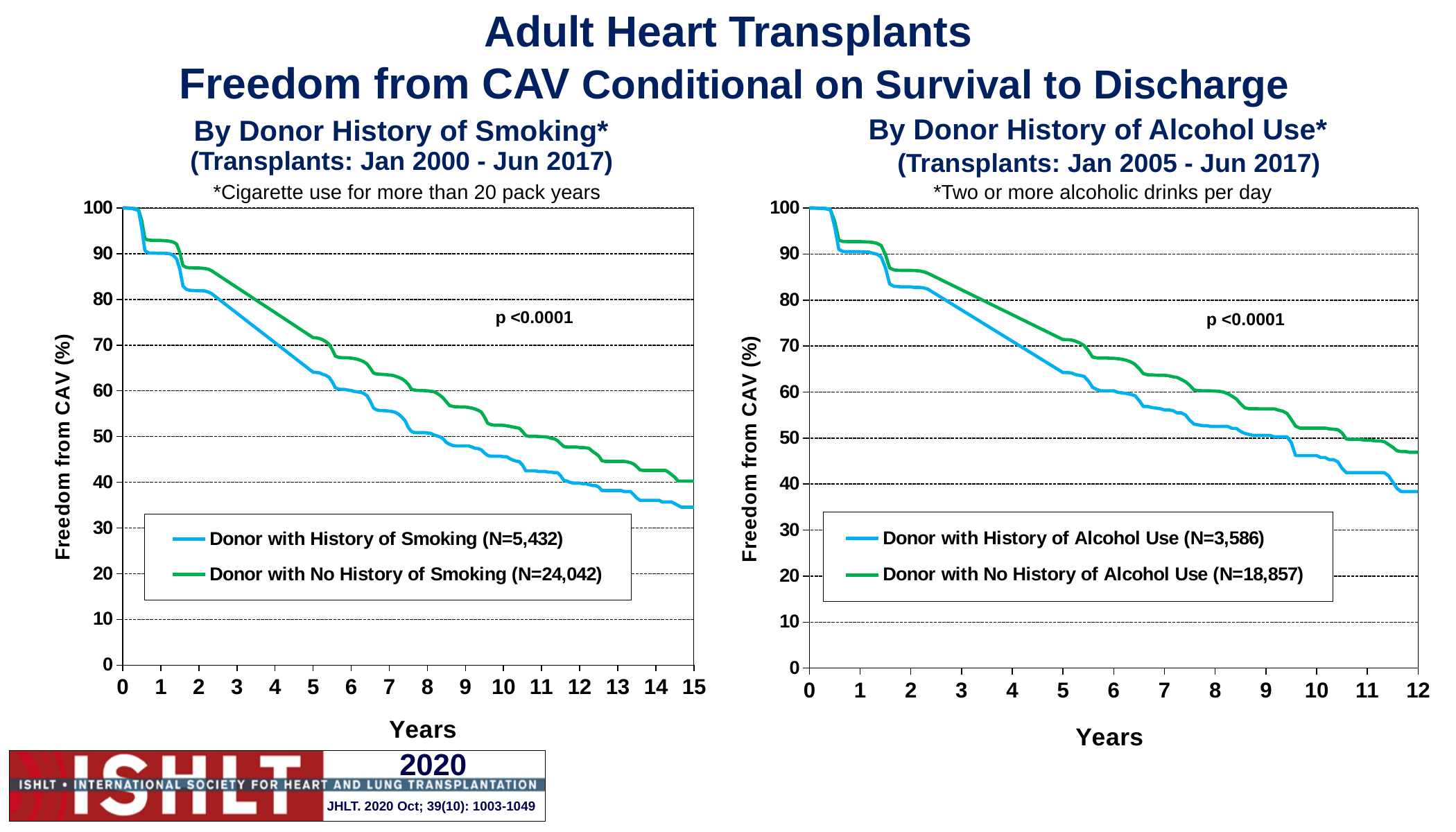
In the 'By Donor History of Alcohol Use' chart, is the value for 'Donor with No History of Alcohol Use' at 12 years greater or less than 50? less In the 'By Donor History of Smoking' chart, is the value for 'Donor with No History of Smoking' at 10 years greater or less than 50? greater What type of chart is used in the 'By Donor History of Smoking' chart on the left? line chart In the 'By Donor History of Smoking' chart, what is the N for the 'Donor with History of Smoking' series? N=5,432 In the 'By Donor History of Alcohol Use' chart, which series is higher at 8 years, 'Donor with History of Alcohol Use' or 'Donor with No History of Alcohol Use'? Donor with No History of Alcohol Use In the 'By Donor History of Alcohol Use' chart, is the value for 'Donor with History of Alcohol Use' at 12 years greater or less than 40? less How many series does the legend list in the 'By Donor History of Alcohol Use' chart on the right? 2 In the 'By Donor History of Smoking' chart, which series is higher at 10 years, 'Donor with History of Smoking' or 'Donor with No History of Smoking'? Donor with No History of Smoking In the 'By Donor History of Alcohol Use' chart, what is the N for the 'Donor with No History of Alcohol Use' series? N=18,857 In the 'By Donor History of Smoking' chart, do the values rise or fall as years increase? fall